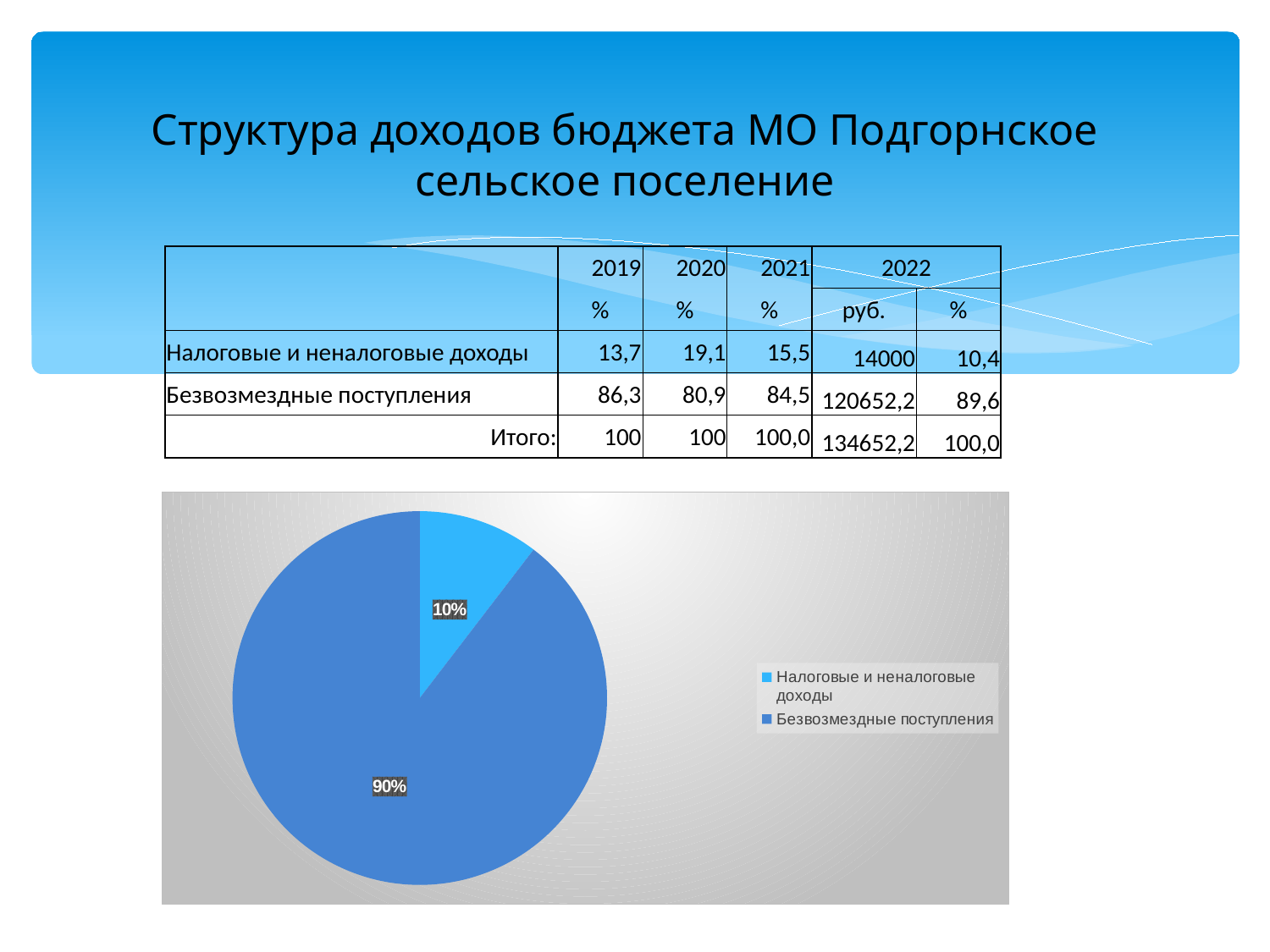
Which slice of the pie chart is the largest? Безвозмездные поступления What is the difference in percentage points between the "Безвозмездные поступления" slice and the "Налоговые и неналоговые доходы" slice? 80 percentage points How many slices does the pie chart have? 2 What kind of chart is shown on the slide? pie chart Which legend entry is shown in the lighter blue colour in the pie chart? Налоговые и неналоговые доходы Where is the legend positioned relative to the pie? to the right What share of the pie does "Налоговые и неналоговые доходы" take? 10% What share of the pie does "Безвозмездные поступления" take? 90% Which slice of the pie chart is the smallest? Налоговые и неналоговые доходы Which is larger in the pie chart: "Налоговые и неналоговые доходы" or "Безвозмездные поступления"? Безвозмездные поступления How many entries does the pie chart's legend list? 2